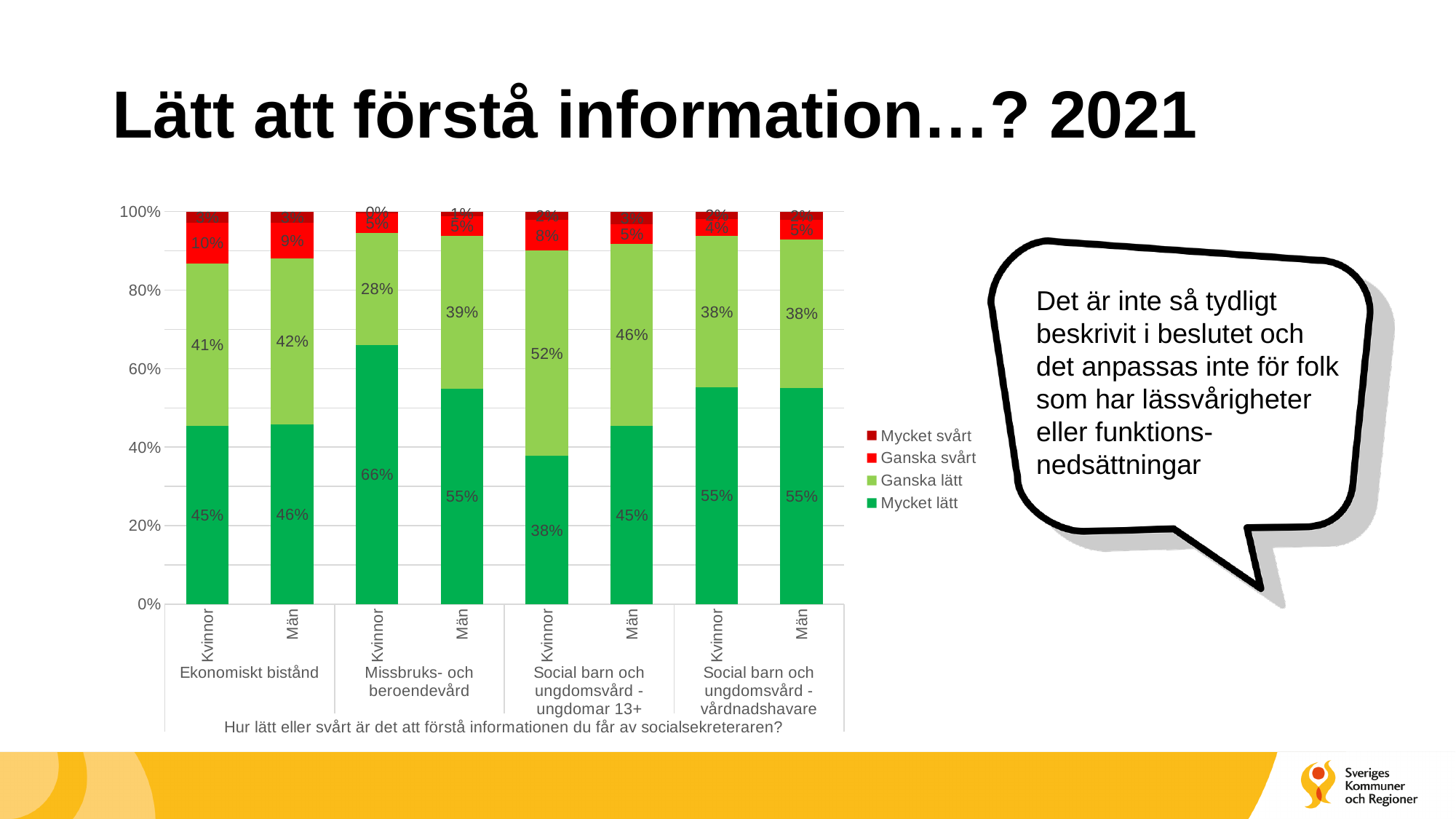
What is the 'Ganska lätt' value for Kvinnor in Social barn och ungdomsvård - ungdomar 13+? 52% How many bars are plotted in the chart? 8 What is the 'Mycket lätt' value for Kvinnor in Missbruks- och beroendevård? 66% Which bar has the lowest 'Mycket lätt' value? Kvinnor, Social barn och ungdomsvård - ungdomar 13+ What kind of chart is shown on the slide? stacked bar chart Which legend entry is shown in dark green? Mycket lätt Which is larger: the 'Ganska lätt' value for Kvinnor in Ekonomiskt bistånd or for Kvinnor in Missbruks- och beroendevård? Kvinnor in Ekonomiskt bistånd How many series does the legend list? 4 What is the 'Mycket lätt' value for Män in Social barn och ungdomsvård - vårdnadshavare? 55% What is the 'Ganska svårt' value for Kvinnor in Ekonomiskt bistånd? 10% What is the difference between the 'Mycket lätt' values for Kvinnor and Män in Missbruks- och beroendevård? 11% Which bar has the highest 'Mycket lätt' value? Kvinnor, Missbruks- och beroendevård